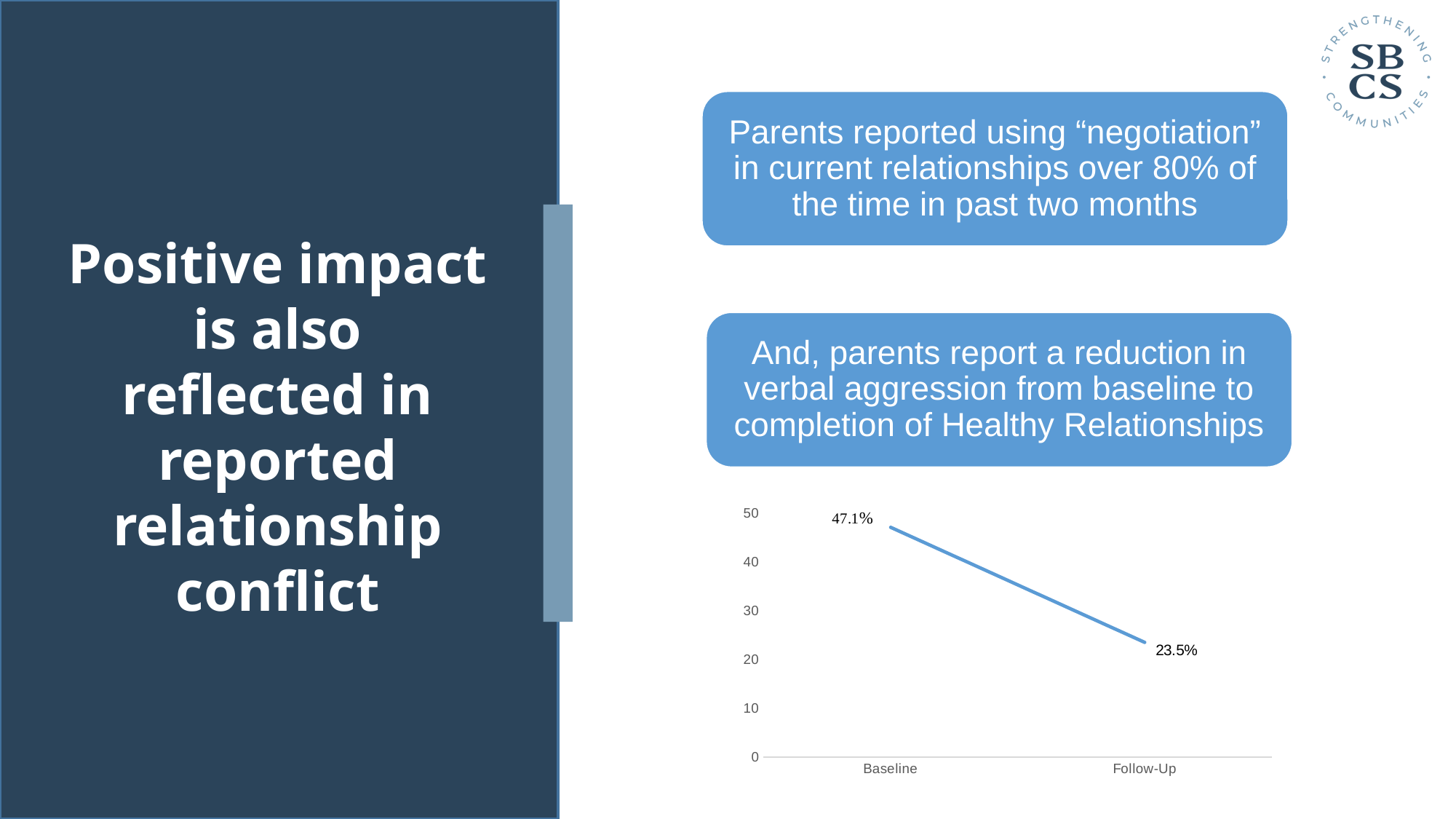
How many data points are plotted on the chart? 2 Do the values rise or fall from Baseline to Follow-Up? fall Is the value at Baseline greater or less than 40? greater What is the value at Baseline? 47.1% Is the value at Baseline larger or smaller than the value at Follow-Up? larger What is the value at Follow-Up? 23.5% Is the value at Follow-Up greater or less than 30? less Which point has the higher value, Baseline or Follow-Up? Baseline What kind of chart is shown on the slide? line chart What is the highest value shown on the vertical axis? 50 What is the difference between the Baseline and Follow-Up values? 23.6% Which point has the lowest value? Follow-Up